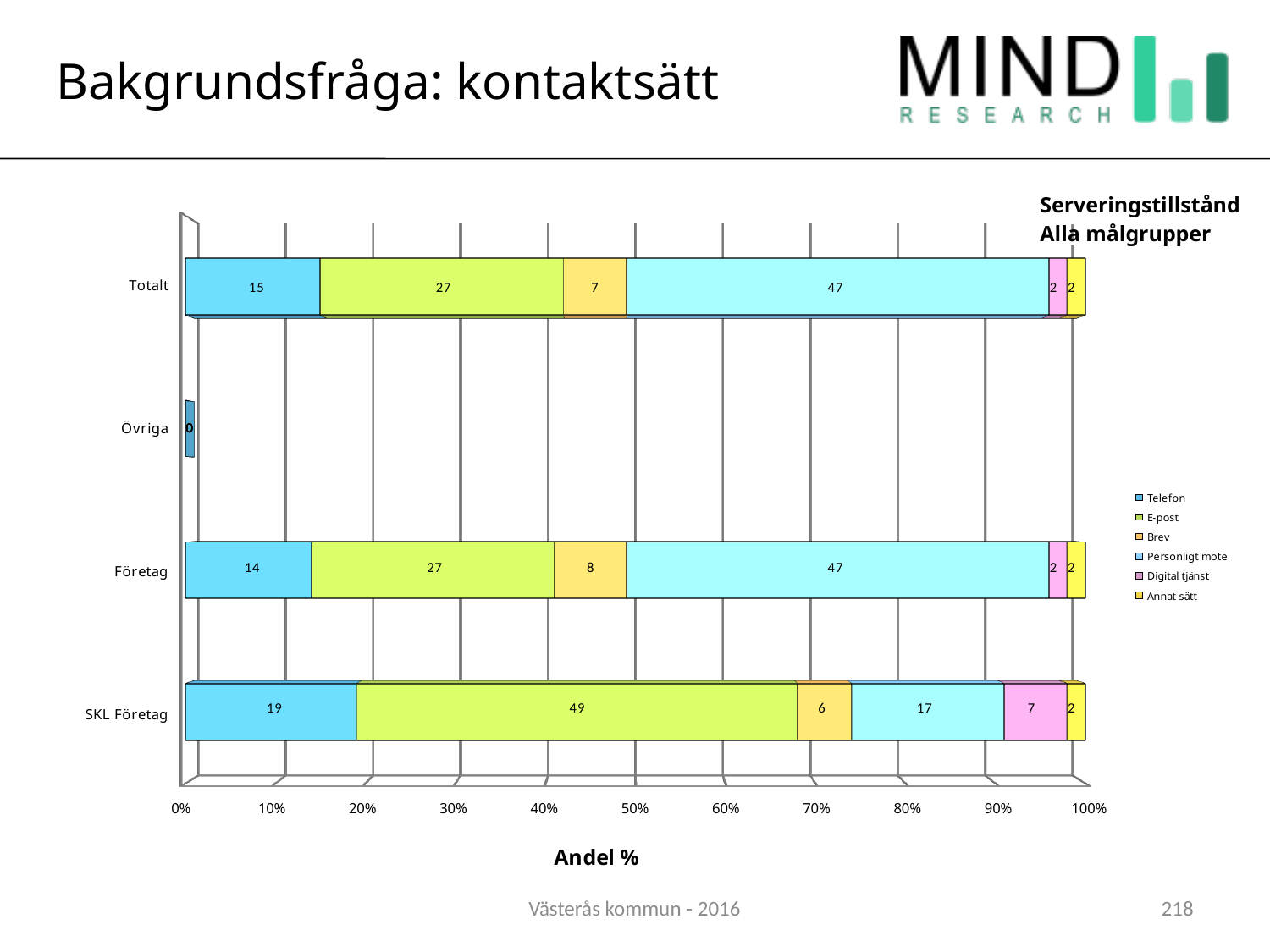
How many series does the legend list? 6 What is the difference between the Telefon values for SKL Företag and Företag? 5 What is the value for Personligt möte in the Totalt bar? 47 How many categories are shown on the vertical axis? 4 Which is larger: the Personligt möte value for Företag or the E-post value for SKL Företag? E-post value for SKL Företag What is the value for Brev in the Företag bar? 8 Which category has the highest value for E-post? SKL Företag What is the label on the horizontal axis? Andel % What is the value for E-post in the SKL Företag bar? 49 Which category has the lowest value for Personligt möte among Totalt, Företag and SKL Företag? SKL Företag What kind of chart is shown on the slide? stacked bar chart What is the value for Digital tjänst in the SKL Företag bar? 7